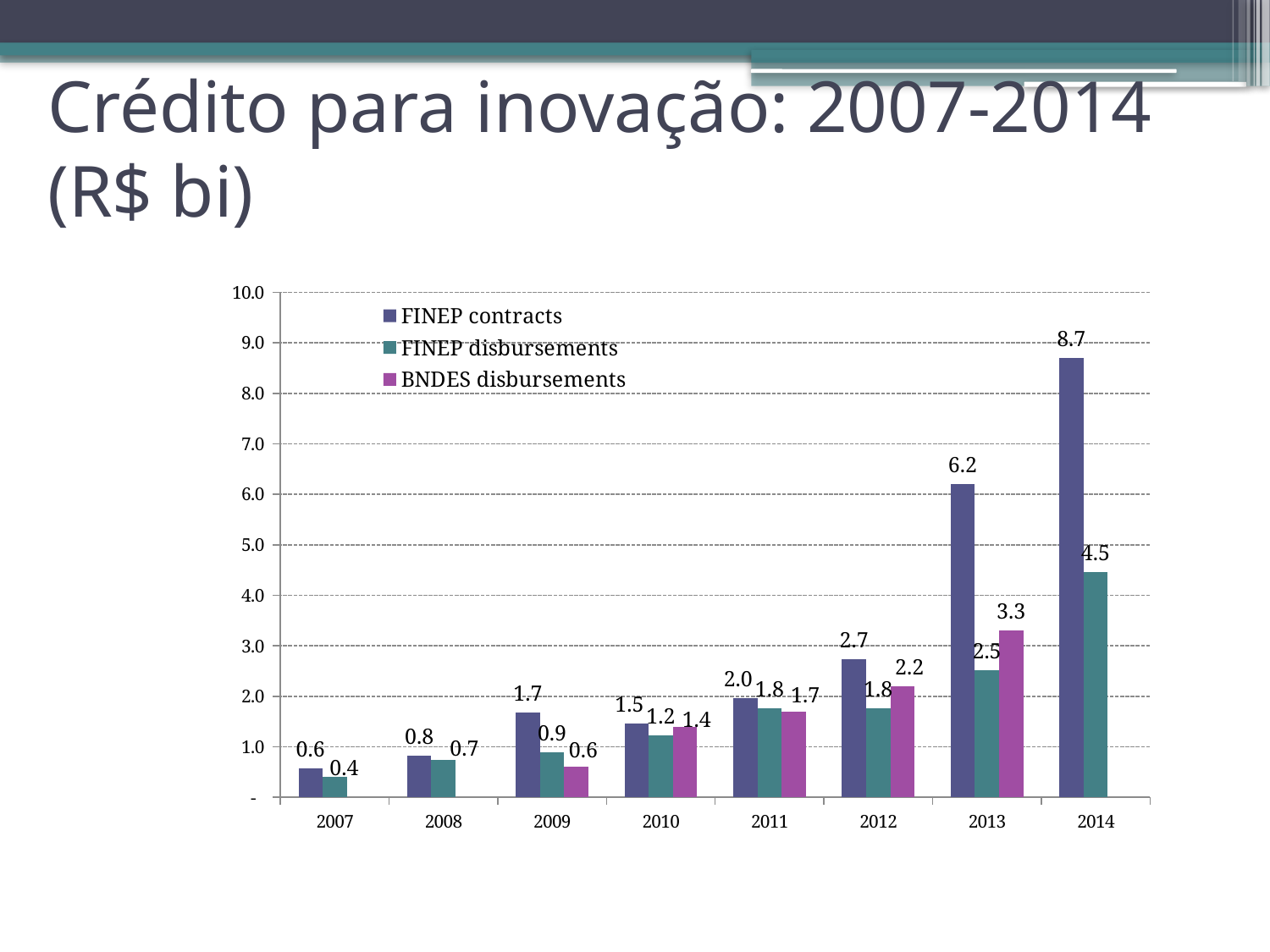
What is the title of the slide containing the chart? Crédito para inovação: 2007-2014 (R$ bi) How many years are shown on the x axis? 8 What is the value of FINEP disbursements in 2010? 1.2 Do FINEP contracts rise or fall from 2012 to 2014? Rise What kind of chart is shown on the slide? Bar chart In which year are FINEP disbursements lowest? 2007 Which is larger in 2012: FINEP disbursements or BNDES disbursements? BNDES disbursements In which year are FINEP contracts highest? 2014 What is the value of BNDES disbursements in 2013? 3.3 How many series does the legend list? 3 What is the value of FINEP contracts in 2014? 8.7 What is the difference between FINEP contracts and FINEP disbursements in 2013? 3.7